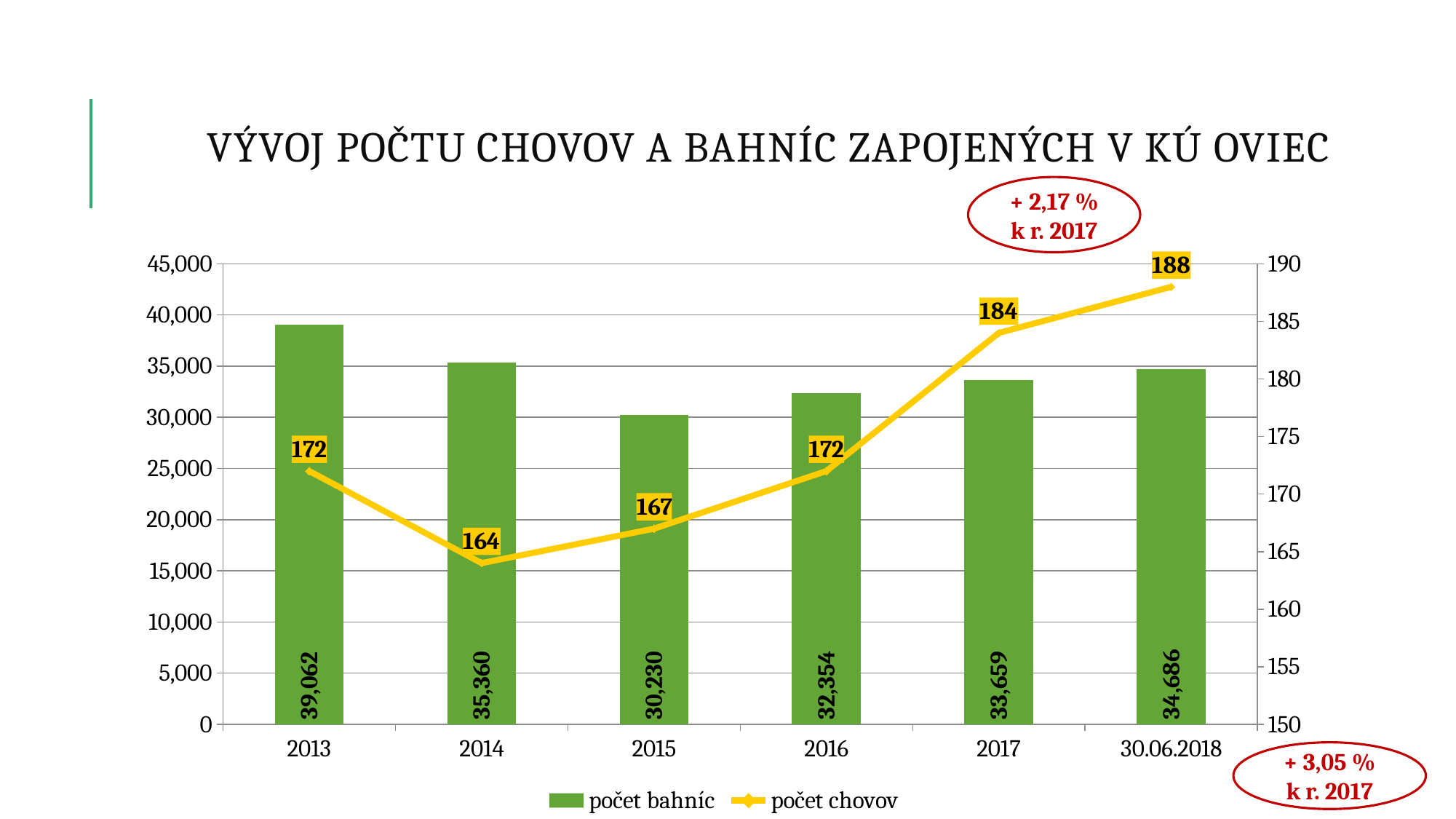
How many series does the legend list? 2 Which is larger, počet bahníc in 2016 or in 2017? 2017 What is the difference between počet bahníc in 2013 and in 2014? 3,702 What is the value of počet bahníc for 2013? 39,062 Which year has the lowest value of počet bahníc? 2015 Does počet chovov rise or fall from 2014 to 30.06.2018? rise Which category has the highest value of počet chovov? 30.06.2018 What is the value of počet chovov for 2014? 164 How many categories are shown on the x axis? 6 What is the difference between počet chovov in 30.06.2018 and in 2017? 4 What is the value of počet bahníc for 30.06.2018? 34,686 What is the title of the chart? VÝVOJ POČTU CHOVOV A BAHNÍC ZAPOJENÝCH V KÚ OVIEC